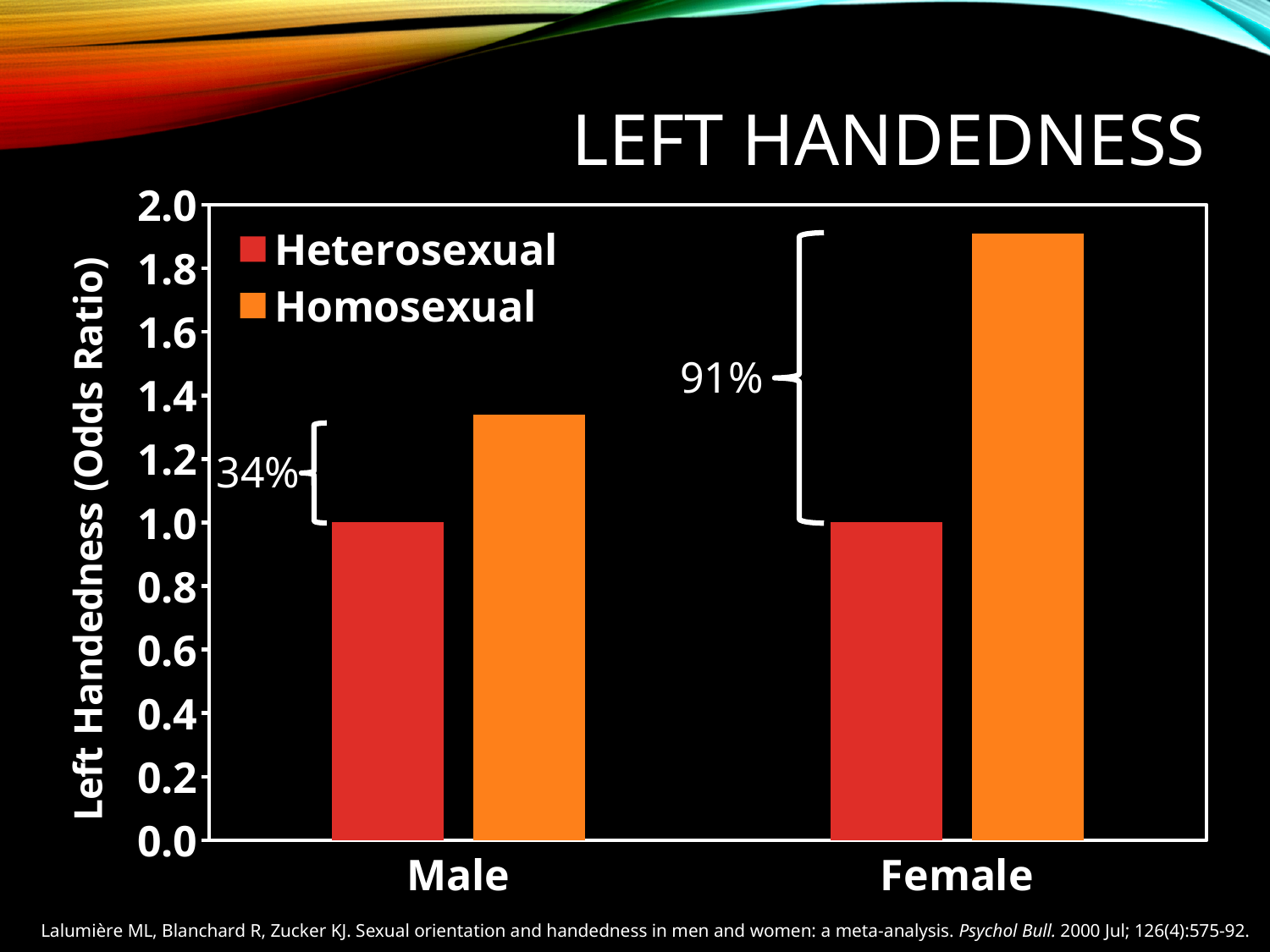
What is the Heterosexual odds ratio value for Male? 1.0 Is the Homosexual value for Male greater or less than 1.2? greater What percentage is annotated next to the bracket for the Female category? 91% Is the Homosexual value for Male greater or less than 1.4? less Is the Homosexual value for Female greater or less than 1.8? greater How many categories are shown on the x axis? 2 What type of chart is shown on the slide? bar chart What is the title of the chart? LEFT HANDEDNESS What is the Heterosexual odds ratio value for Female? 1.0 Which is larger, the Homosexual value for Male or the Homosexual value for Female? Female Which bar is the highest in the chart? Homosexual Female How many series does the legend list? 2